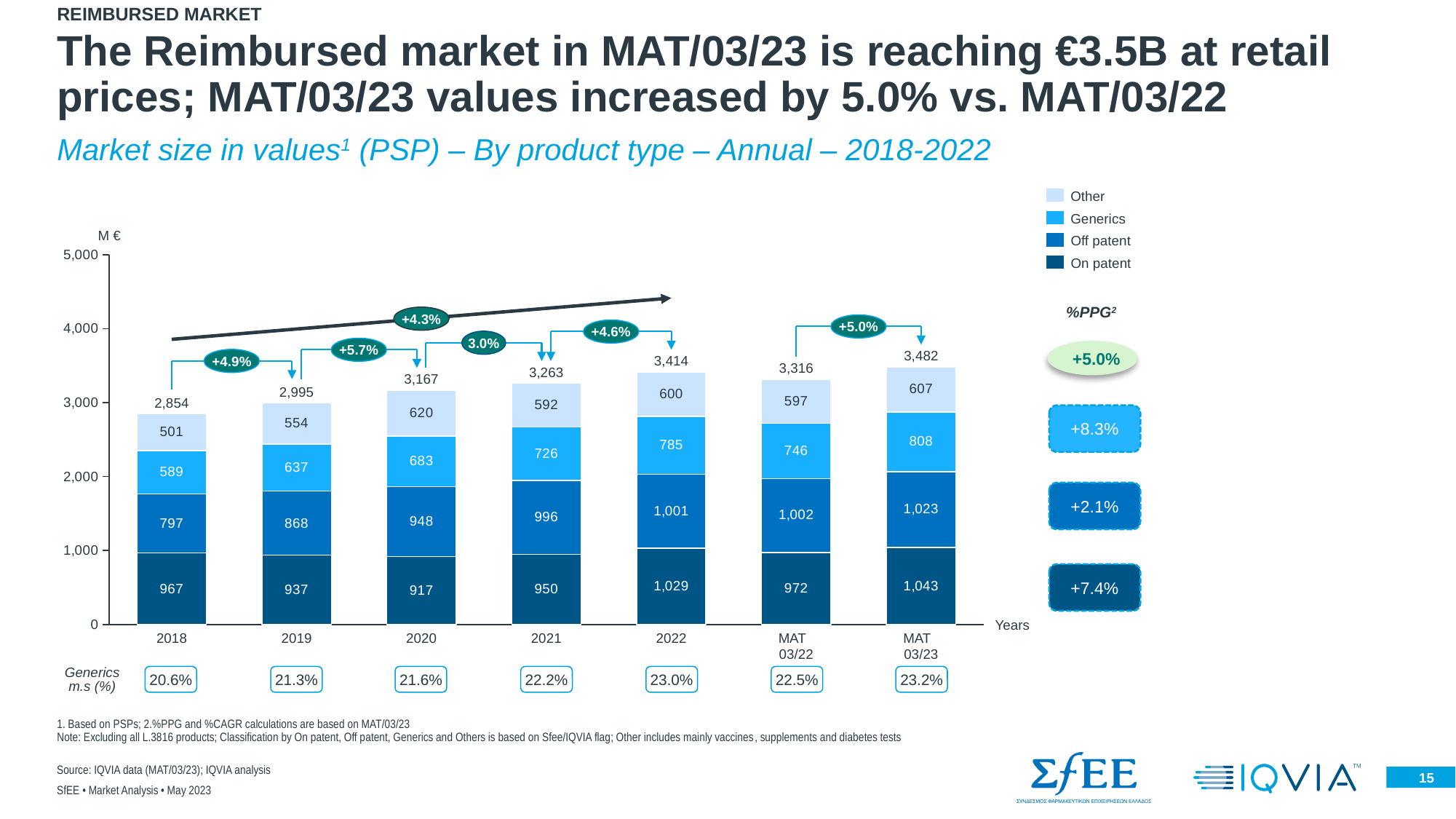
What kind of chart is shown on the slide? Stacked bar chart Which year or period has the lowest total market value? 2018 What is the Generics value for 2020? 683 How many series does the legend list? 4 What is the difference between the Off patent values for MAT 03/23 and MAT 03/22? 21 What is the Generics market share (m.s %) shown for 2022? 23.0% What is the Other value for 2019? 554 What is the On patent value for 2022? 1,029 How many bars are plotted on the chart? 7 Which is larger, the Generics value for 2021 or the Generics value for 2019? 2021 Which year or period has the highest total market value? MAT 03/23 What is the total value of the stacked bar for MAT 03/23? 3,482